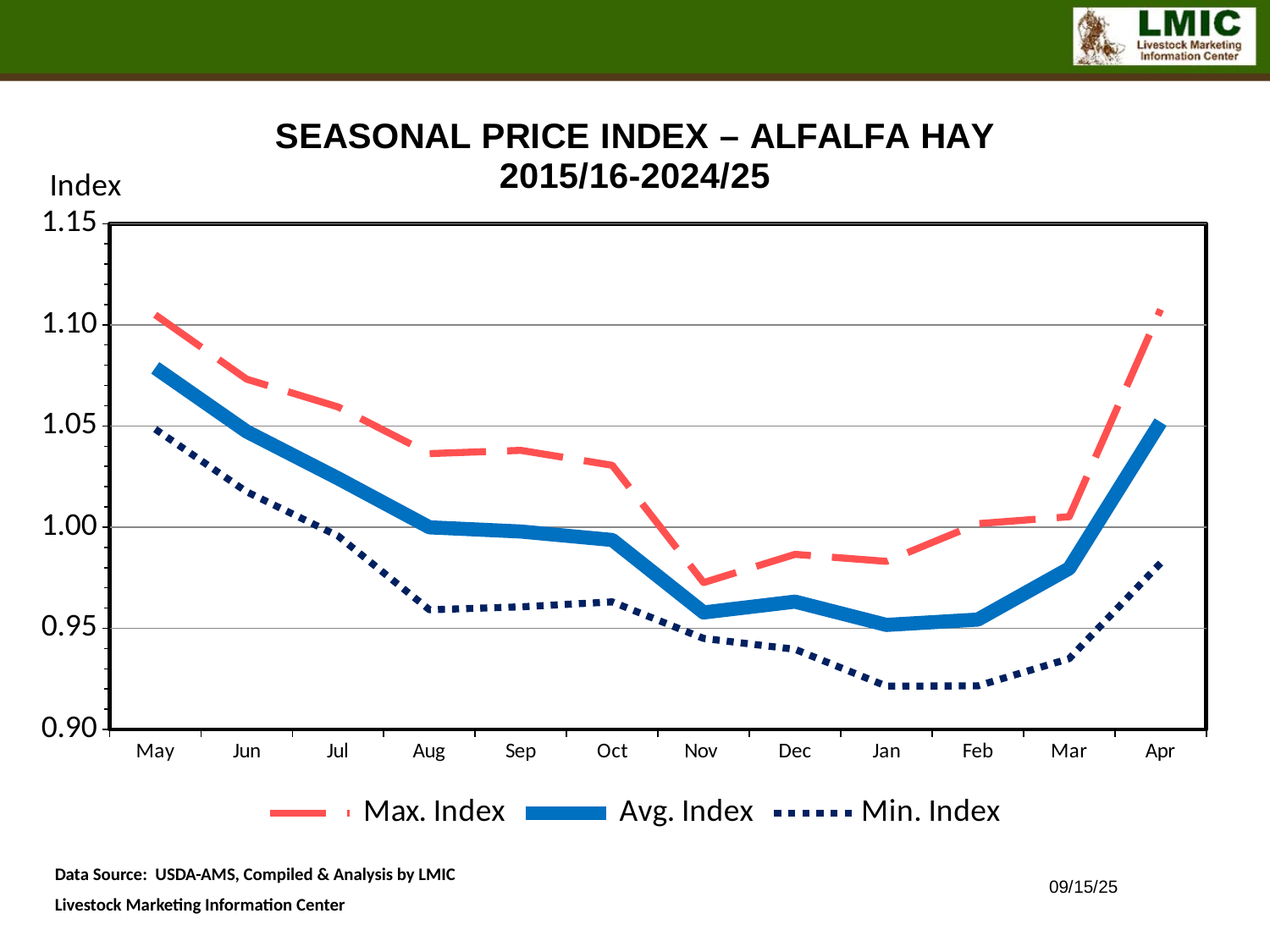
In which month is the Min. Index at its highest? May What kind of chart is shown on the slide? line chart Does the Avg. Index rise or fall from May to Nov? fall Is the Max. Index value for Nov greater or less than 1.00? less Is the Avg. Index value for May greater or less than 1.05? greater In which month is the Max. Index at its lowest? Nov In which month is the Avg. Index at its highest? May How many months are plotted along the x axis? 12 How many series does the legend list? 3 Is the Min. Index value for Jan greater or less than 0.95? less What is the title of the chart? SEASONAL PRICE INDEX – ALFALFA HAY 2015/16-2024/25 Which is larger, the Avg. Index in May or the Avg. Index in Apr? May